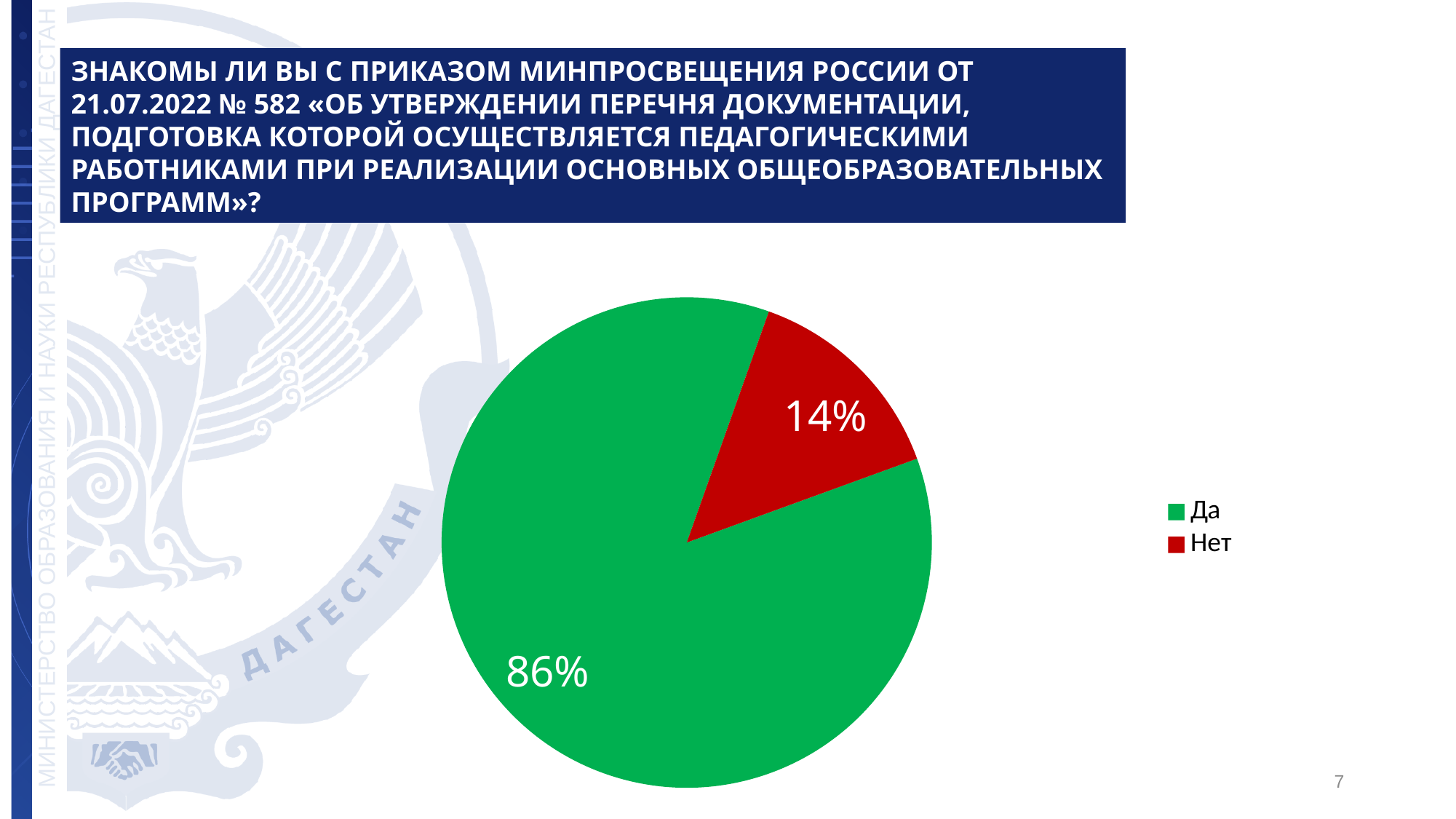
What colour is the "Да" slice? green Which answer has the largest share of the pie? Да What is the difference in percentage points between the "Да" and "Нет" slices? 72 Which answer has the smallest share of the pie? Нет What kind of chart is shown on the slide? pie chart What colour is the "Нет" slice? red Which is larger, the share for "Да" or the share for "Нет"? Да How many entries does the legend list? 2 What percentage of respondents answered "Нет"? 14% What percentage of respondents answered "Да"? 86% What share of the pie does the "Нет" slice represent? 14% How many slices does the pie chart have? 2